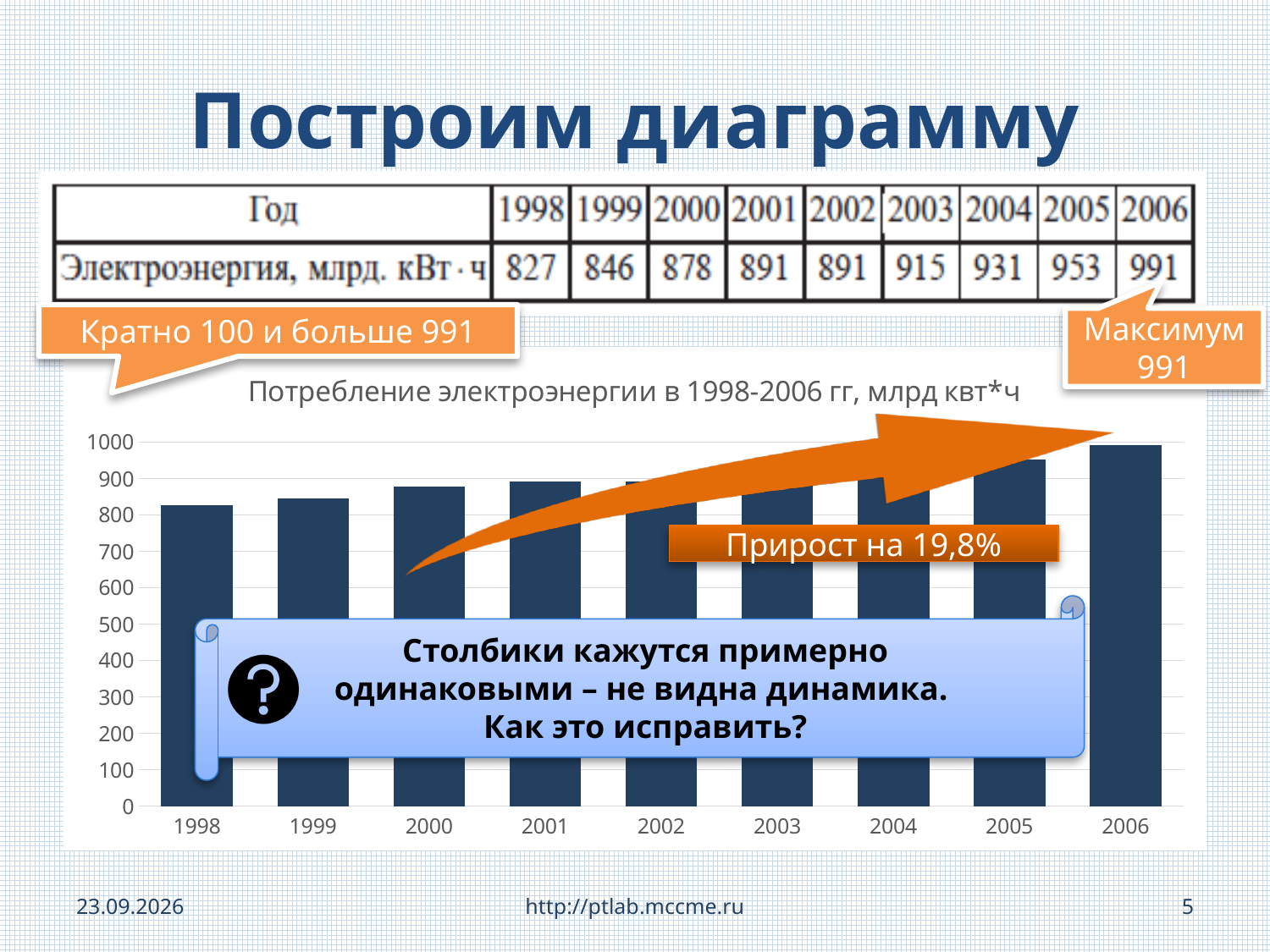
What is the title of the chart? Потребление электроэнергии в 1998-2006 гг, млрд квт*ч What is the electricity consumption value for 2006? 991 Which year has the lowest electricity consumption in the chart? 1998 Is the value for 1998 greater or less than 900? less What is the electricity consumption value for 1998? 827 Which year has the highest electricity consumption in the chart? 2006 Which year has the larger value, 2005 or 2003? 2005 What is the difference between the values for 2006 and 1998? 164 What is the electricity consumption value for 2003? 915 How many years (bars) are plotted in the chart? 9 What kind of chart is shown on the slide? bar chart Do the values rise or fall from 1998 to 2006? rise